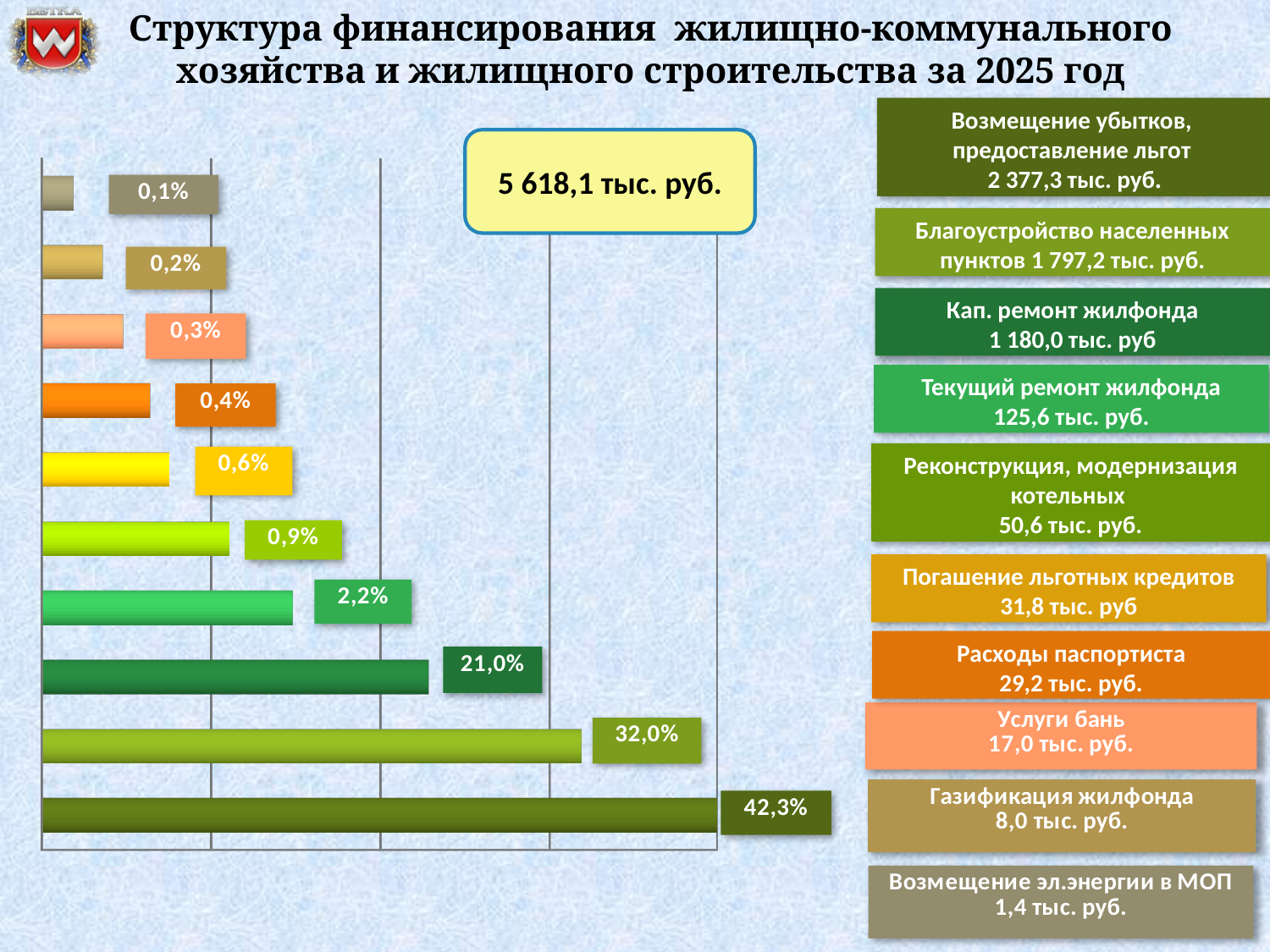
What is the largest percentage shown on any bar in the chart? 42,3% What percentage is shown on the bar for Кап. ремонт жилфонда (the dark green bar)? 21,0% What total amount is shown in the yellow box above the chart? 5 618,1 тыс. руб. According to the legend, what amount is allocated to Услуги бань? 17,0 тыс. руб. How many bars are plotted in the chart? 10 What is the smallest percentage shown on any bar in the chart? 0,1% What type of chart is shown on the slide? bar chart Which is larger: the share for Текущий ремонт жилфонда (2,2%) or the share for Реконструкция, модернизация котельных (0,9%)? Текущий ремонт жилфонда What percentage is shown on the bar for Возмещение убытков, предоставление льгот (the dark olive-green bar)? 42,3% What percentage is shown on the bar for Благоустройство населенных пунктов (the light green bar)? 32,0% What is the difference in percentage points between the 42,3% bar and the 32,0% bar? 10,3 What percentage is shown on the orange bar (Расходы паспортиста)? 0,4%